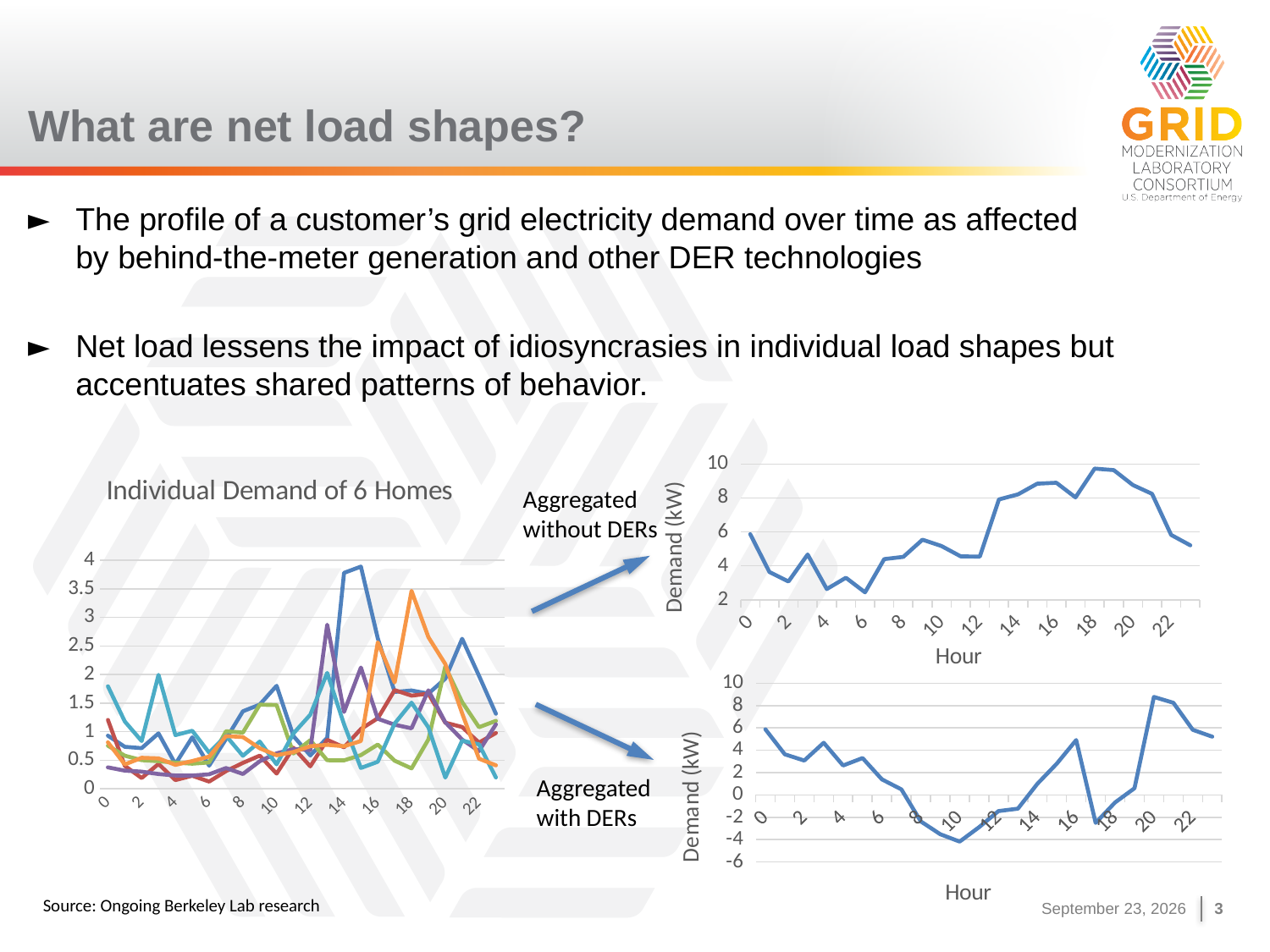
In the 'Aggregated without DERs' chart, which is larger: the value at hour 0 or the value at hour 19? hour 19 In the 'Aggregated with DERs' chart, is the value at hour 20 greater or less than 6? greater How many homes' demand lines are plotted in the 'Individual Demand of 6 Homes' chart? 6 What type of chart is the 'Individual Demand of 6 Homes' chart? line chart In the 'Aggregated without DERs' chart, is the value at hour 6 greater or less than 4? less In the 'Aggregated with DERs' chart, at which hour is demand lowest? 10 What is the y-axis label of the 'Aggregated with DERs' chart? Demand (kW) In the 'Aggregated without DERs' chart, is the value at hour 19 greater or less than 8? greater In the 'Aggregated without DERs' chart, do values rise or fall from hour 19 to hour 23? fall In the 'Aggregated with DERs' chart, do values rise or fall from hour 6 to hour 10? fall In the 'Aggregated without DERs' chart, at which hour is demand highest? 18